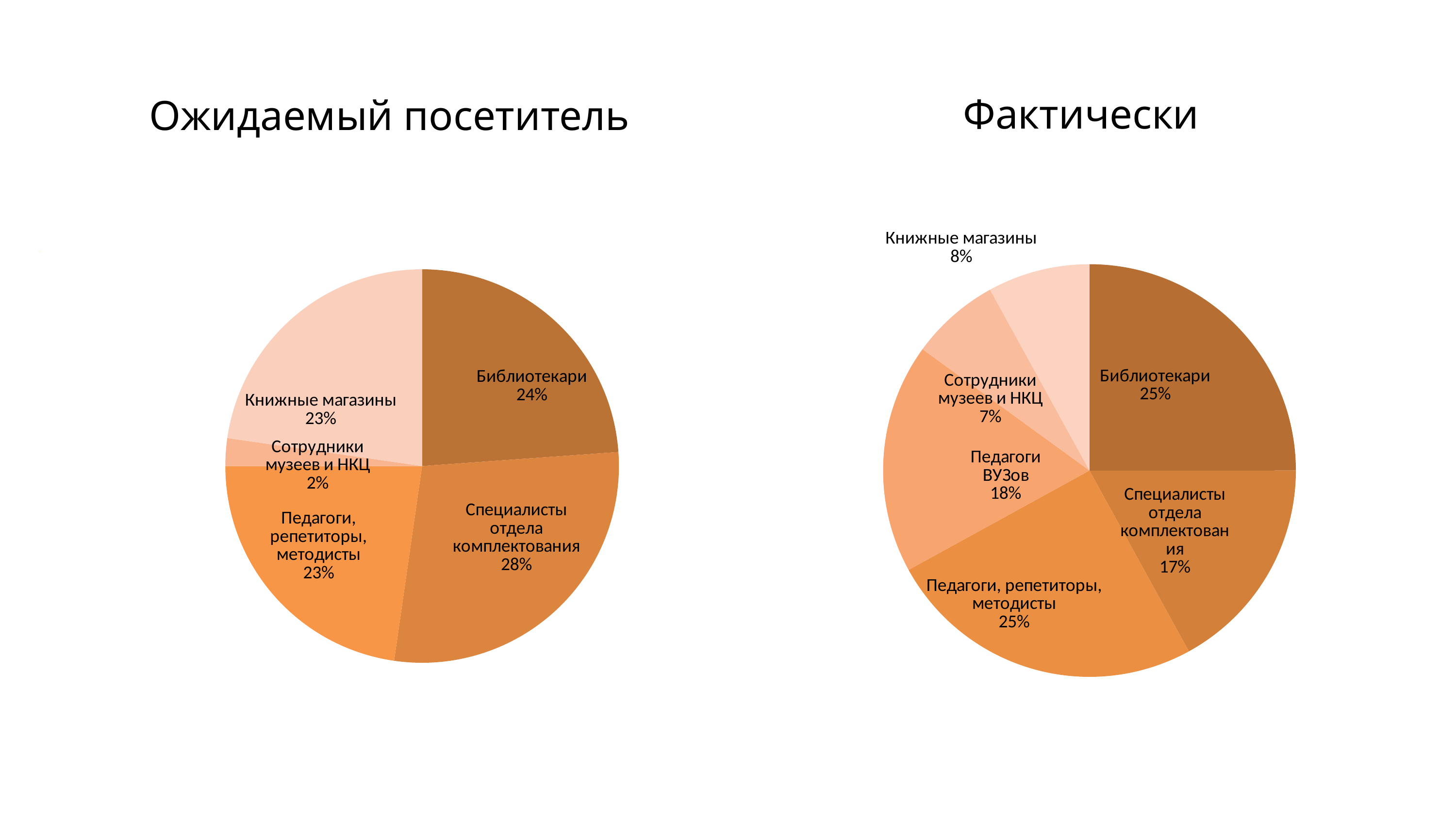
In the 'Фактически' chart, what is the difference between the shares of Библиотекари and Специалисты отдела комплектования? 8% Which is larger: the share of Книжные магазины in the 'Ожидаемый посетитель' chart or in the 'Фактически' chart? Ожидаемый посетитель What type of chart is shown under the title 'Фактически'? Pie chart In the 'Ожидаемый посетитель' chart, which category has the smallest slice? Сотрудники музеев и НКЦ How many slices does the 'Фактически' pie chart have? 6 In the 'Фактически' chart, what share do Педагоги ВУЗов have? 18% How many slices does the 'Ожидаемый посетитель' pie chart have? 5 In the 'Фактически' chart, which category has the smallest slice? Сотрудники музеев и НКЦ In the 'Ожидаемый посетитель' chart, what share do Библиотекари have? 24% In the 'Ожидаемый посетитель' chart, what share do Специалисты отдела комплектования have? 28% In the 'Ожидаемый посетитель' chart, which category has the largest slice? Специалисты отдела комплектования